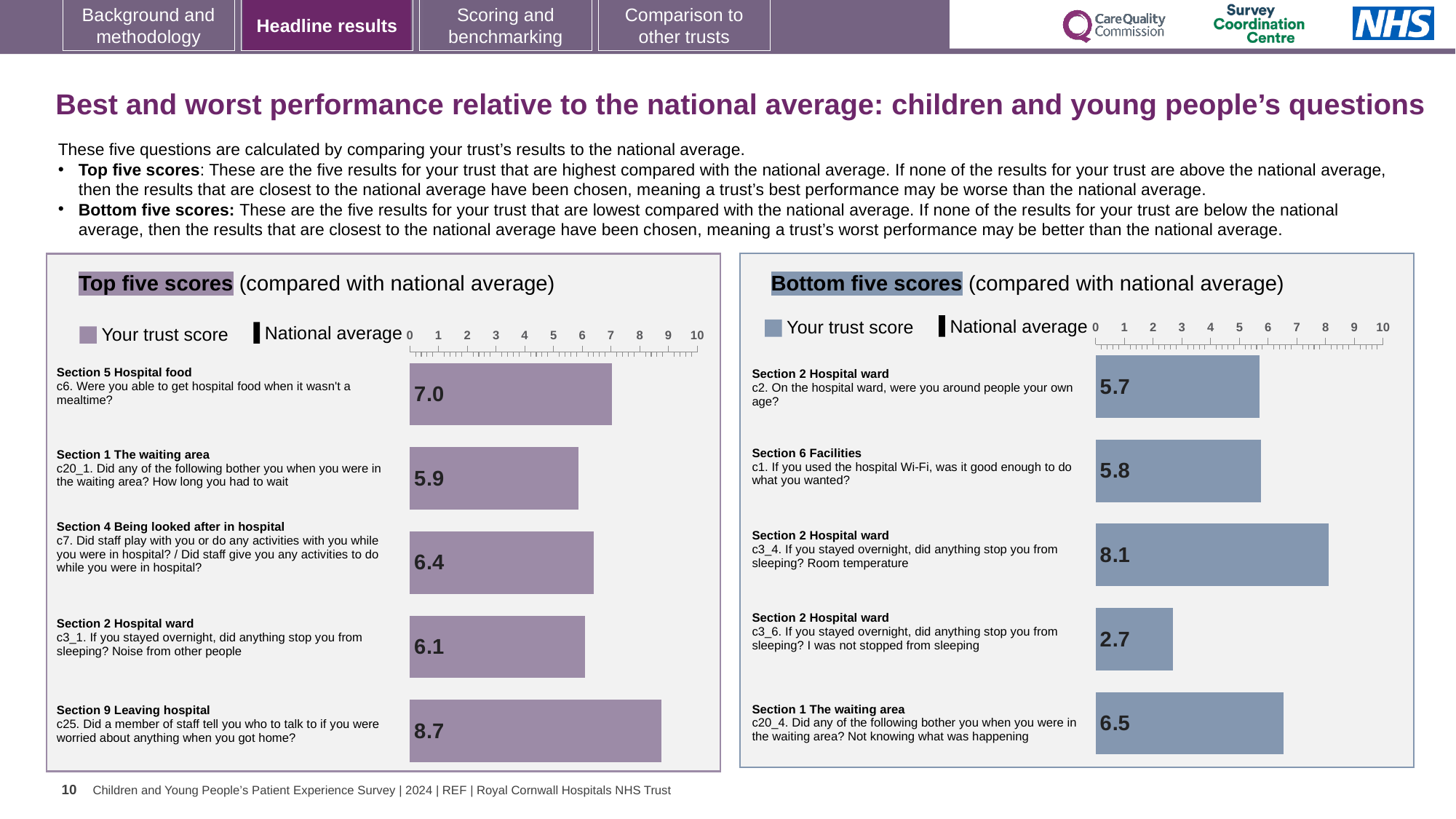
In the Bottom five scores chart, which question has the lowest trust score? c3_6. If you stayed overnight, did anything stop you from sleeping? I was not stopped from sleeping In the Top five scores chart, which question has the lowest trust score? c20_1. Did any of the following bother you when you were in the waiting area? How long you had to wait What type of chart is the Top five scores chart? Bar chart In the Bottom five scores chart, which has the larger trust score: c3_4 (Room temperature) or c20_4 (Not knowing what was happening)? c3_4 (Room temperature) In the Bottom five scores chart, what is the trust score for c3_6 (I was not stopped from sleeping)? 2.7 In the Top five scores chart, what is the trust score for c25 (Did a member of staff tell you who to talk to if you were worried about anything when you got home?)? 8.7 In the Top five scores chart, what is the difference between the trust scores for c25 and c6? 1.7 How many questions are plotted in the Bottom five scores chart? 5 In the Bottom five scores chart, what is the trust score for c1 (If you used the hospital Wi-Fi, was it good enough to do what you wanted?)? 5.8 In the Bottom five scores chart, which question has the highest trust score? c3_4. If you stayed overnight, did anything stop you from sleeping? Room temperature In the Top five scores chart, what is the trust score for c6 (Were you able to get hospital food when it wasn't a mealtime?)? 7.0 In the Top five scores chart, which question has the highest trust score? c25. Did a member of staff tell you who to talk to if you were worried about anything when you got home?